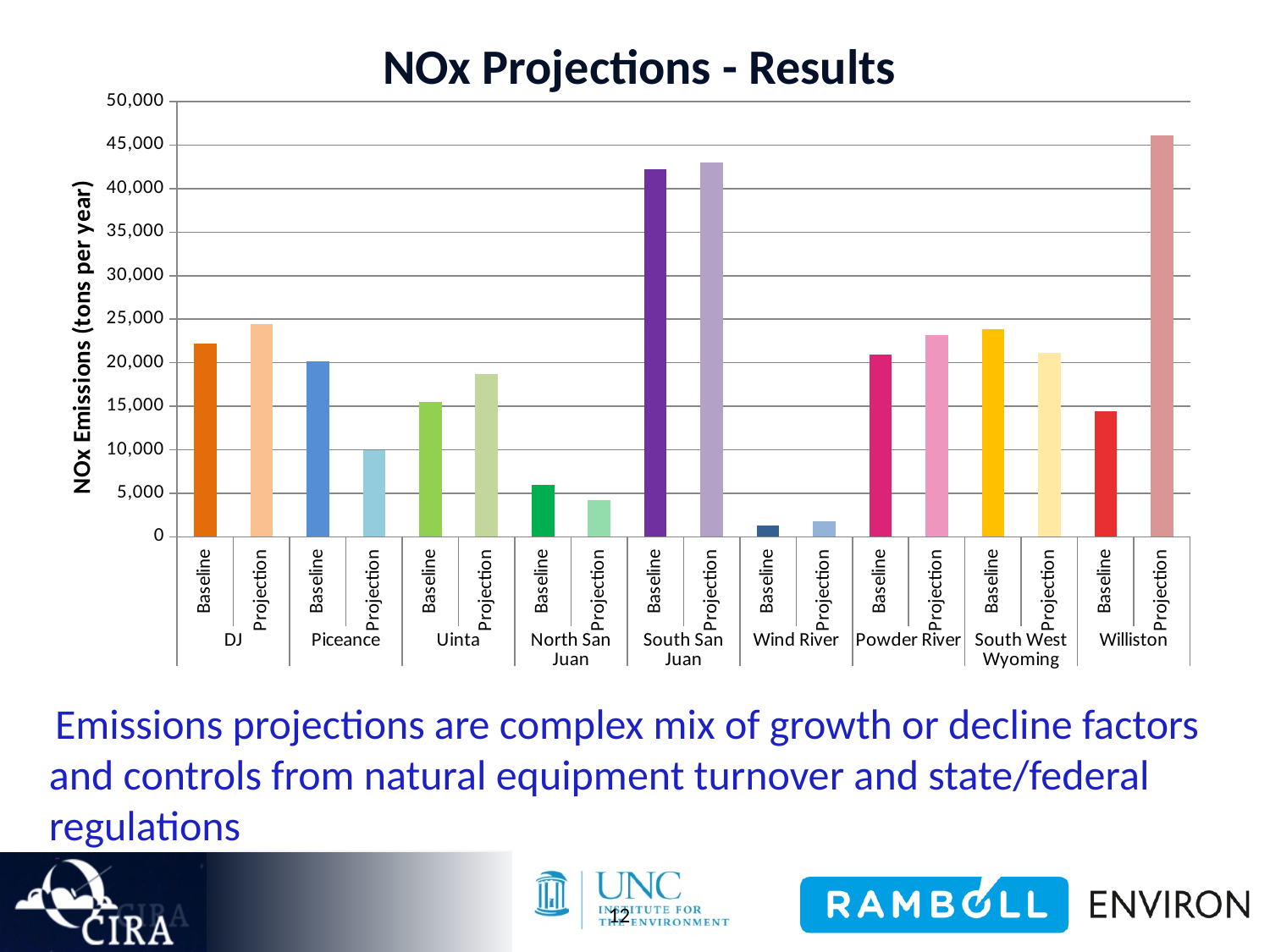
What is the title of the chart? NOx Projections - Results Is the Williston Projection value greater or less than 45,000? greater Is the Piceance Projection value greater or less than 15,000? less For Piceance, which is larger, the Baseline or the Projection value? Baseline For Williston, which is larger, the Baseline or the Projection value? Projection Which bar has the highest NOx emissions value in the chart? Williston Projection Is the South San Juan Baseline value greater or less than 40,000? greater What kind of chart is shown on the slide? bar chart What is the y-axis label of the chart? NOx Emissions (tons per year) How many basins (category groups) are shown on the x axis? 9 Which bar has the lowest NOx emissions value in the chart? Wind River Baseline